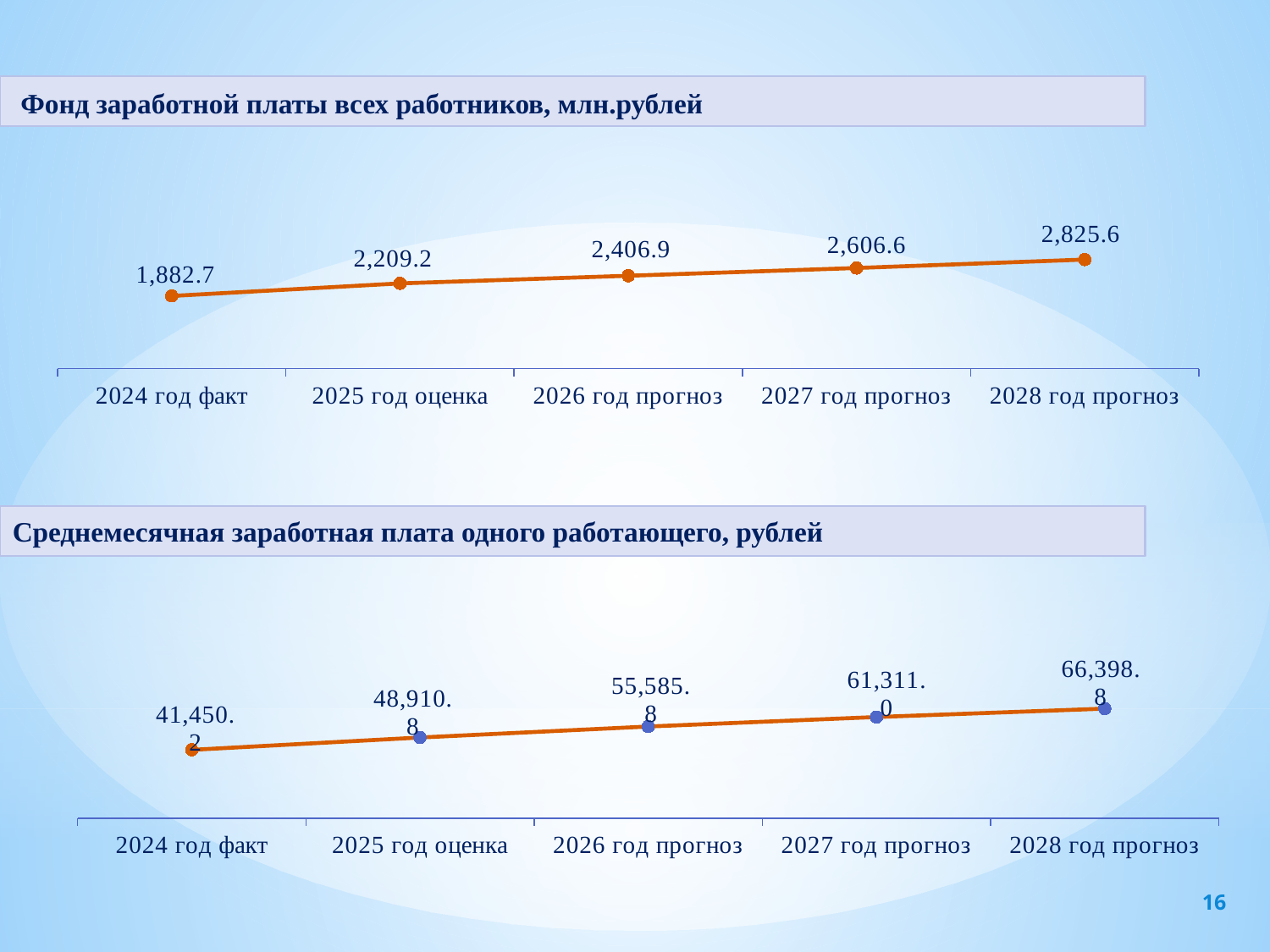
In the chart 'Среднемесячная заработная плата одного работающего, рублей', what is the value for 2027 год прогноз? 61,311.0 In the chart 'Фонд заработной платы всех работников, млн.рублей', how many data points are plotted? 5 In the chart 'Среднемесячная заработная плата одного работающего, рублей', which category has the highest value? 2028 год прогноз In the chart 'Среднемесячная заработная плата одного работающего, рублей', which is larger: the value for 2025 год оценка or the value for 2027 год прогноз? 2027 год прогноз In the chart 'Фонд заработной платы всех работников, млн.рублей', do the values rise or fall from 2024 год факт to 2028 год прогноз? rise In the chart 'Фонд заработной платы всех работников, млн.рублей', what is the value for 2025 год оценка? 2,209.2 In the chart 'Фонд заработной платы всех работников, млн.рублей', what is the value for 2028 год прогноз? 2,825.6 In the chart 'Среднемесячная заработная плата одного работающего, рублей', what is the value for 2024 год факт? 41,450.2 In the chart 'Фонд заработной платы всех работников, млн.рублей', what is the difference between the values for 2028 год прогноз and 2024 год факт? 942.9 What kind of chart is the top chart on the slide? line chart In the chart 'Среднемесячная заработная плата одного работающего, рублей', what is the difference between the values for 2026 год прогноз and 2025 год оценка? 6,675.0 In the chart 'Фонд заработной платы всех работников, млн.рублей', which category has the lowest value? 2024 год факт